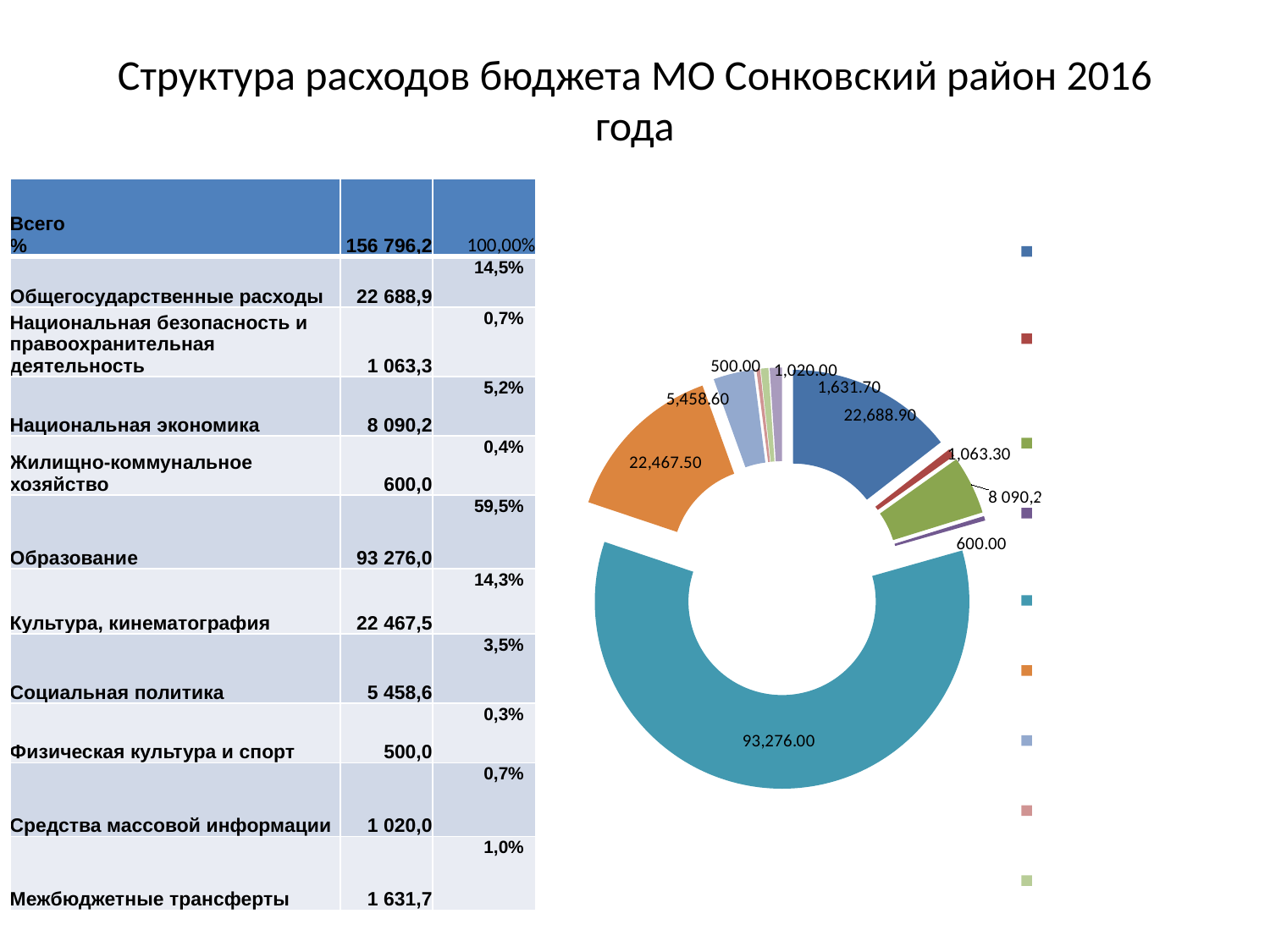
Which slice is larger: the one labelled 22,688.90 or the one labelled 22,467.50? 22,688.90 What kind of chart is shown on the slide? doughnut chart What colour is the largest slice of the doughnut chart? teal How many slices does the doughnut chart have? 10 What is the value shown on the dark blue slice of the doughnut chart? 22,688.90 What is the value of the smallest slice in the doughnut chart? 500.00 What share of the total (156 796,2) does the slice labelled 93,276.00 represent, according to the table? 59,5% What is the title of the slide containing the chart? Структура расходов бюджета МО Сонковский район 2016 года What is the value shown on the orange slice of the doughnut chart? 22,467.50 What is the value of the largest slice in the doughnut chart? 93,276.00 What is the difference between the slice labelled 22,688.90 and the slice labelled 22,467.50? 221.40 What is the value shown on the green slice of the doughnut chart? 8 090,2